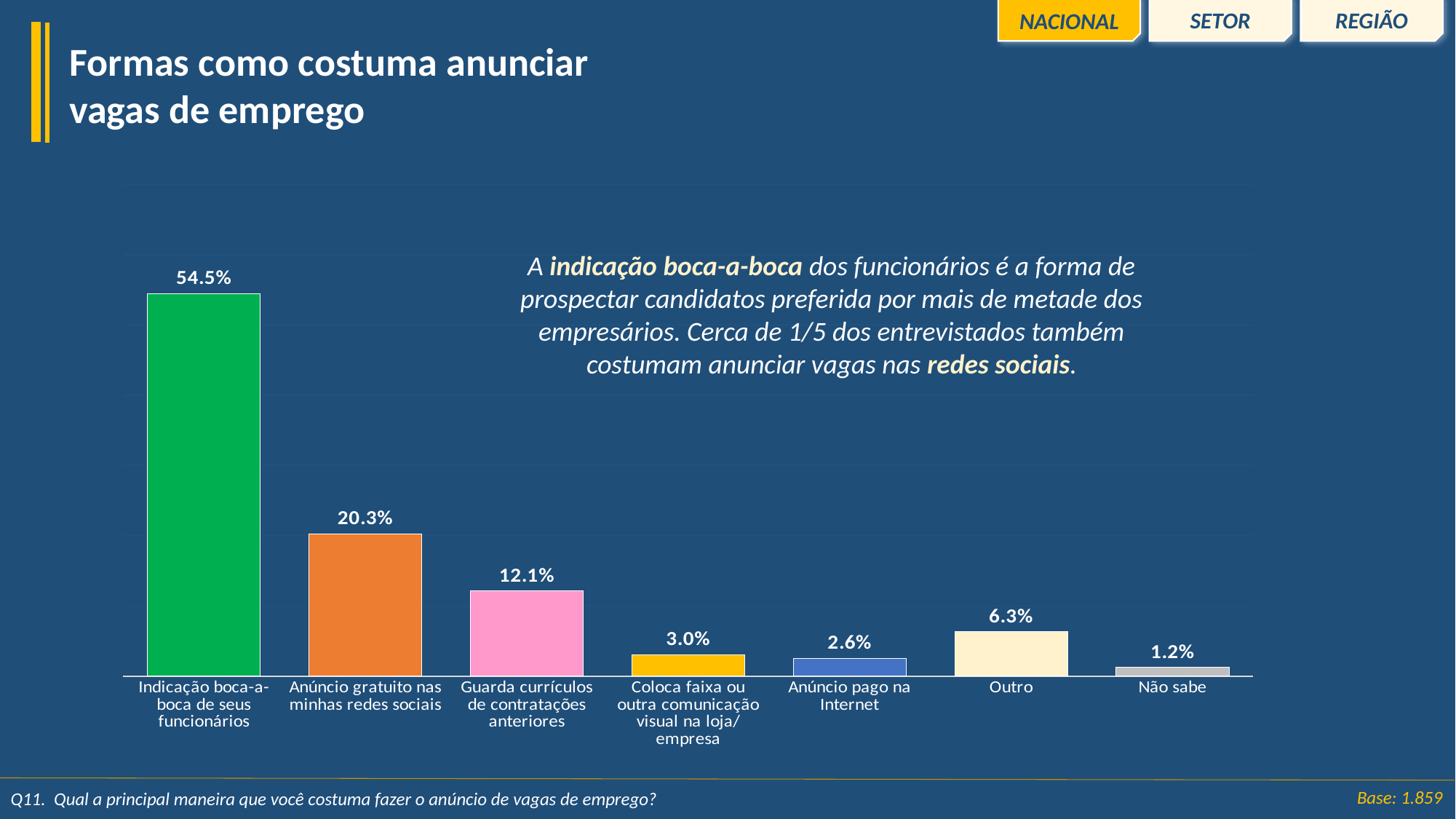
Which is larger: "Outro" or "Coloca faixa ou outra comunicação visual na loja/empresa"? Outro What is the value for "Indicação boca-a-boca de seus funcionários"? 54.5% What kind of chart is shown on the slide? Bar chart Which category has the lowest value? Não sabe What is the difference between "Indicação boca-a-boca de seus funcionários" and "Anúncio gratuito nas minhas redes sociais"? 34.2% What is the value for "Anúncio gratuito nas minhas redes sociais"? 20.3% Which category has the highest value? Indicação boca-a-boca de seus funcionários How many categories are shown in the chart? 7 What is the value for "Guarda currículos de contratações anteriores"? 12.1% What is the value for "Outro"? 6.3% What is the title of the chart on the slide? Formas como costuma anunciar vagas de emprego What is the value for "Anúncio pago na Internet"? 2.6%